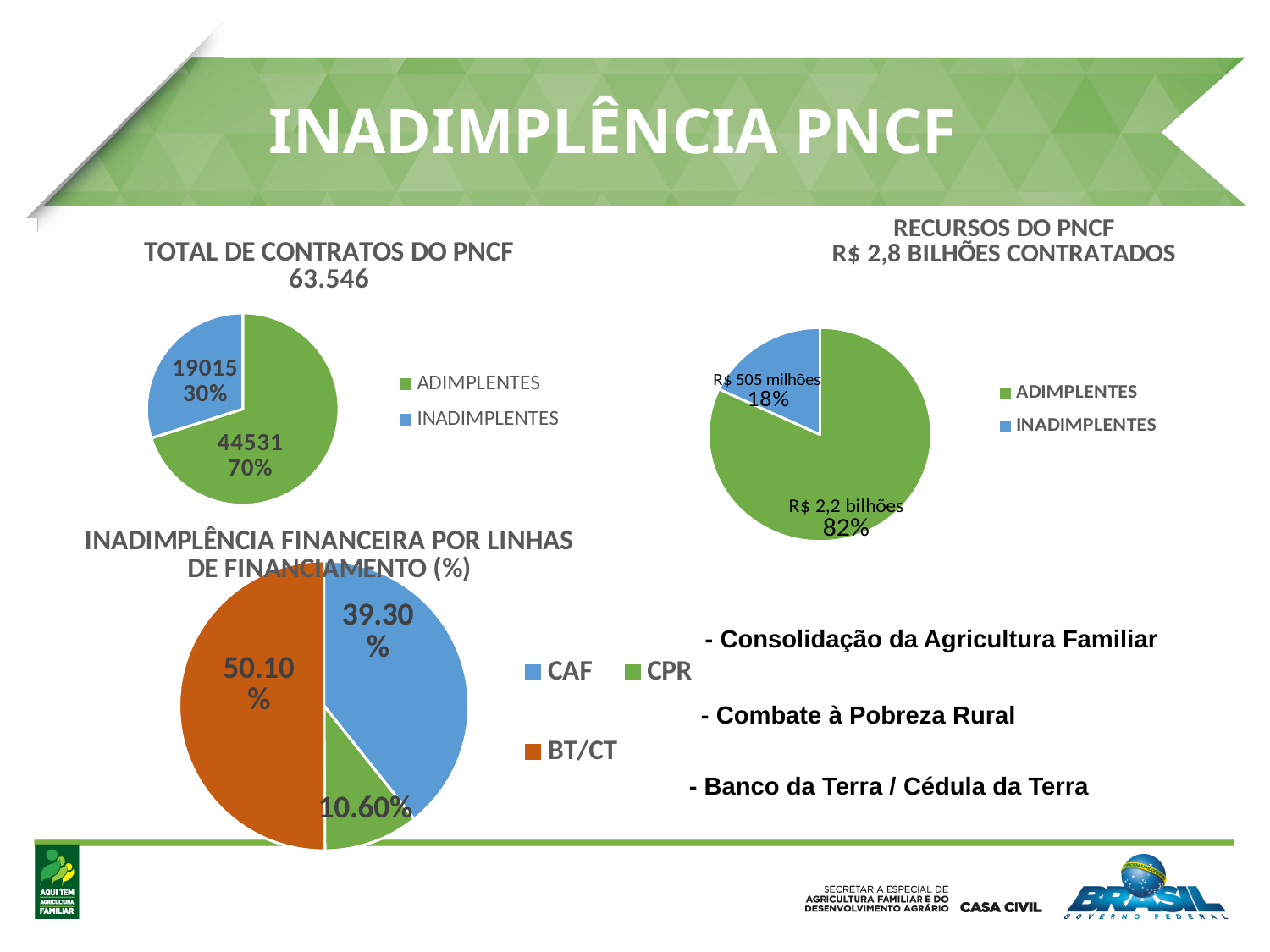
In the chart titled 'INADIMPLÊNCIA FINANCEIRA POR LINHAS DE FINANCIAMENTO (%)', what is the difference between the BT/CT and CPR values? 39.50% In the chart titled 'INADIMPLÊNCIA FINANCEIRA POR LINHAS DE FINANCIAMENTO (%)', what is the value for CAF? 39.30% In the chart titled 'RECURSOS DO PNCF R$ 2,8 BILHÕES CONTRATADOS', what kind of chart is shown? Pie chart In the chart titled 'TOTAL DE CONTRATOS DO PNCF 63.546', what share of the pie is ADIMPLENTES? 70% In the chart titled 'INADIMPLÊNCIA FINANCEIRA POR LINHAS DE FINANCIAMENTO (%)', which line of financing has the lowest share? CPR In the chart titled 'INADIMPLÊNCIA FINANCEIRA POR LINHAS DE FINANCIAMENTO (%)', which line of financing has the highest share? BT/CT In the chart titled 'TOTAL DE CONTRATOS DO PNCF 63.546', what is the difference between the ADIMPLENTES and INADIMPLENTES contract counts? 25516 In the chart titled 'TOTAL DE CONTRATOS DO PNCF 63.546', what is the number of contracts for INADIMPLENTES? 19015 In the chart titled 'RECURSOS DO PNCF R$ 2,8 BILHÕES CONTRATADOS', what share of the pie is ADIMPLENTES? 82% In the chart titled 'INADIMPLÊNCIA FINANCEIRA POR LINHAS DE FINANCIAMENTO (%)', how many categories does the pie show? 3 In the chart titled 'TOTAL DE CONTRATOS DO PNCF 63.546', which category is larger, ADIMPLENTES or INADIMPLENTES? ADIMPLENTES In the chart titled 'RECURSOS DO PNCF R$ 2,8 BILHÕES CONTRATADOS', what is the value for INADIMPLENTES? R$ 505 milhões